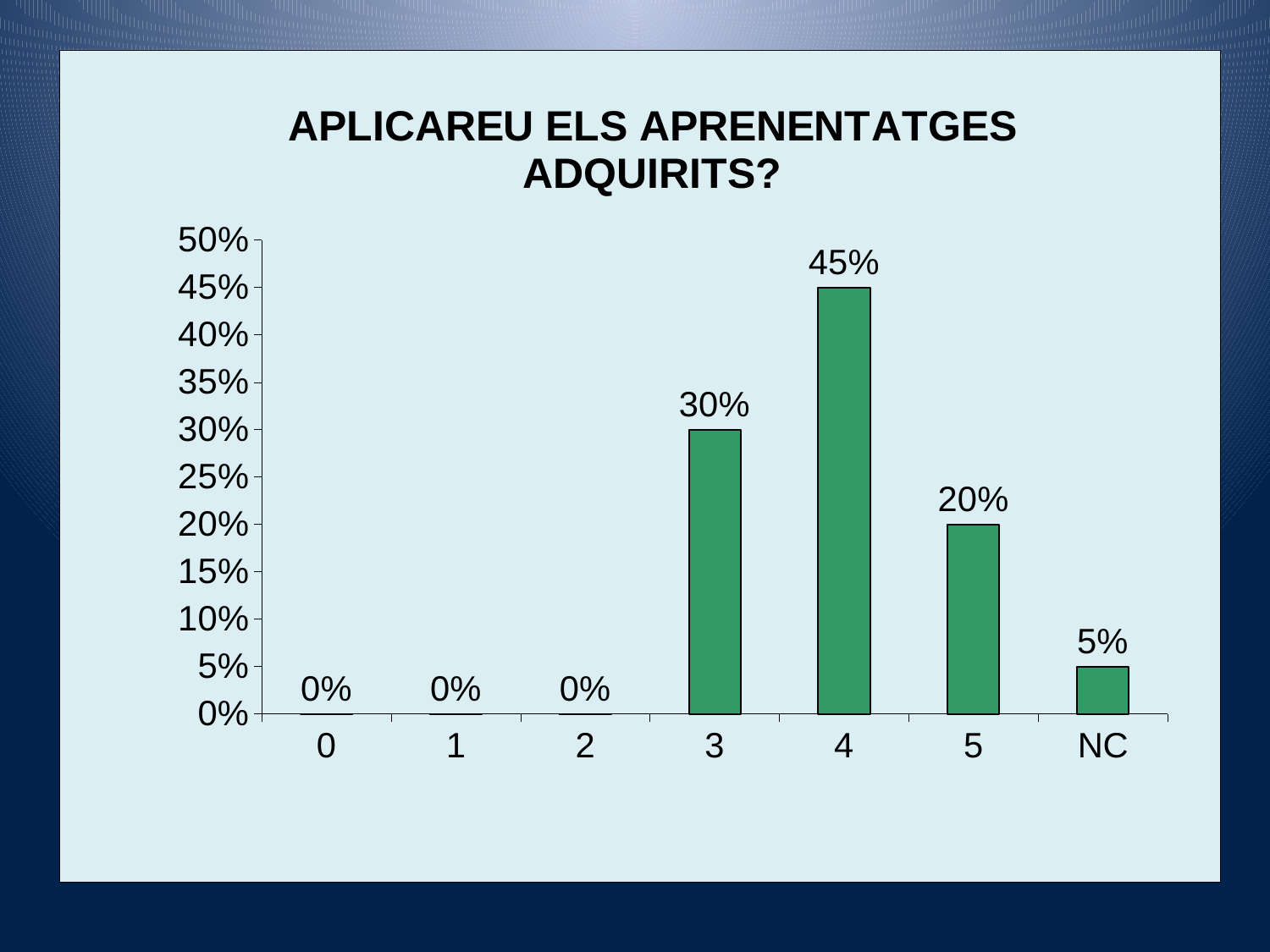
How many categories are shown on the x axis? 7 What kind of chart is shown on the slide? Bar chart What is the value for category 4? 45% Which is larger, the value for category 3 or the value for category 5? 3 What is the difference between the values for categories 4 and 3? 15% What is the title of the chart? APLICAREU ELS APRENENTATGES ADQUIRITS? What is the value for category 3? 30% What is the value for category 5? 20% What is the difference between the values for categories 5 and NC? 15% How many categories have a value of 0%? 3 What is the value for category NC? 5% Which category has the highest value? 4